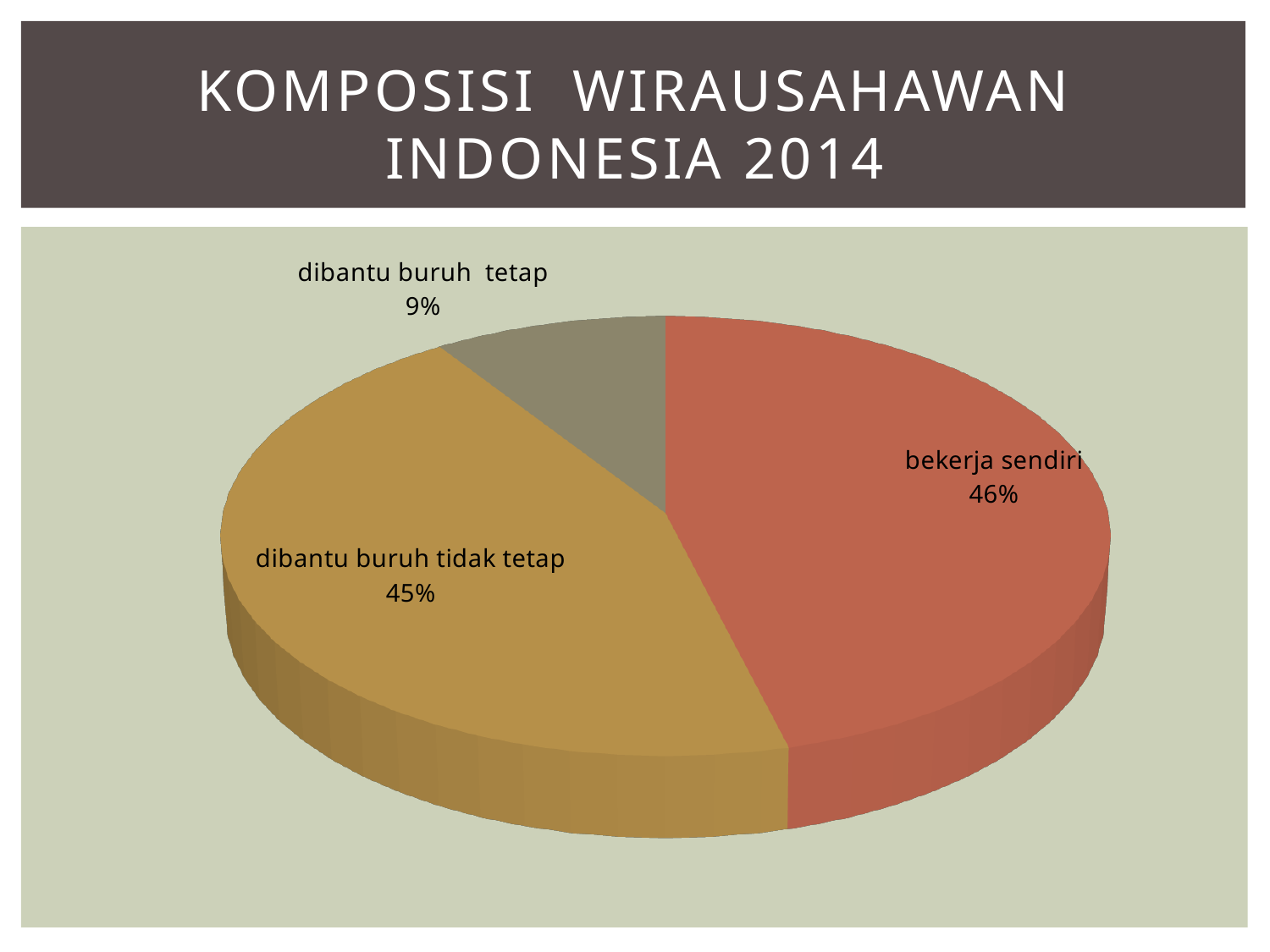
What colour is the 'bekerja sendiri' slice of the pie? red Which category has the smallest share of the pie? dibantu buruh tetap What share of the pie is 'bekerja sendiri'? 46% What is the title of the chart on the slide? KOMPOSISI WIRAUSAHAWAN INDONESIA 2014 What is the difference in percentage points between 'bekerja sendiri' and 'dibantu buruh tetap'? 37 What share of the pie is 'dibantu buruh tidak tetap'? 45% Which is larger, the share for 'dibantu buruh tidak tetap' or the share for 'dibantu buruh tetap'? dibantu buruh tidak tetap What kind of chart is shown on the slide? pie chart What share of the pie is 'dibantu buruh tetap'? 9% What is the difference in percentage points between 'dibantu buruh tidak tetap' and 'dibantu buruh tetap'? 36 How many slices does the pie chart have? 3 Which category has the largest share of the pie? bekerja sendiri